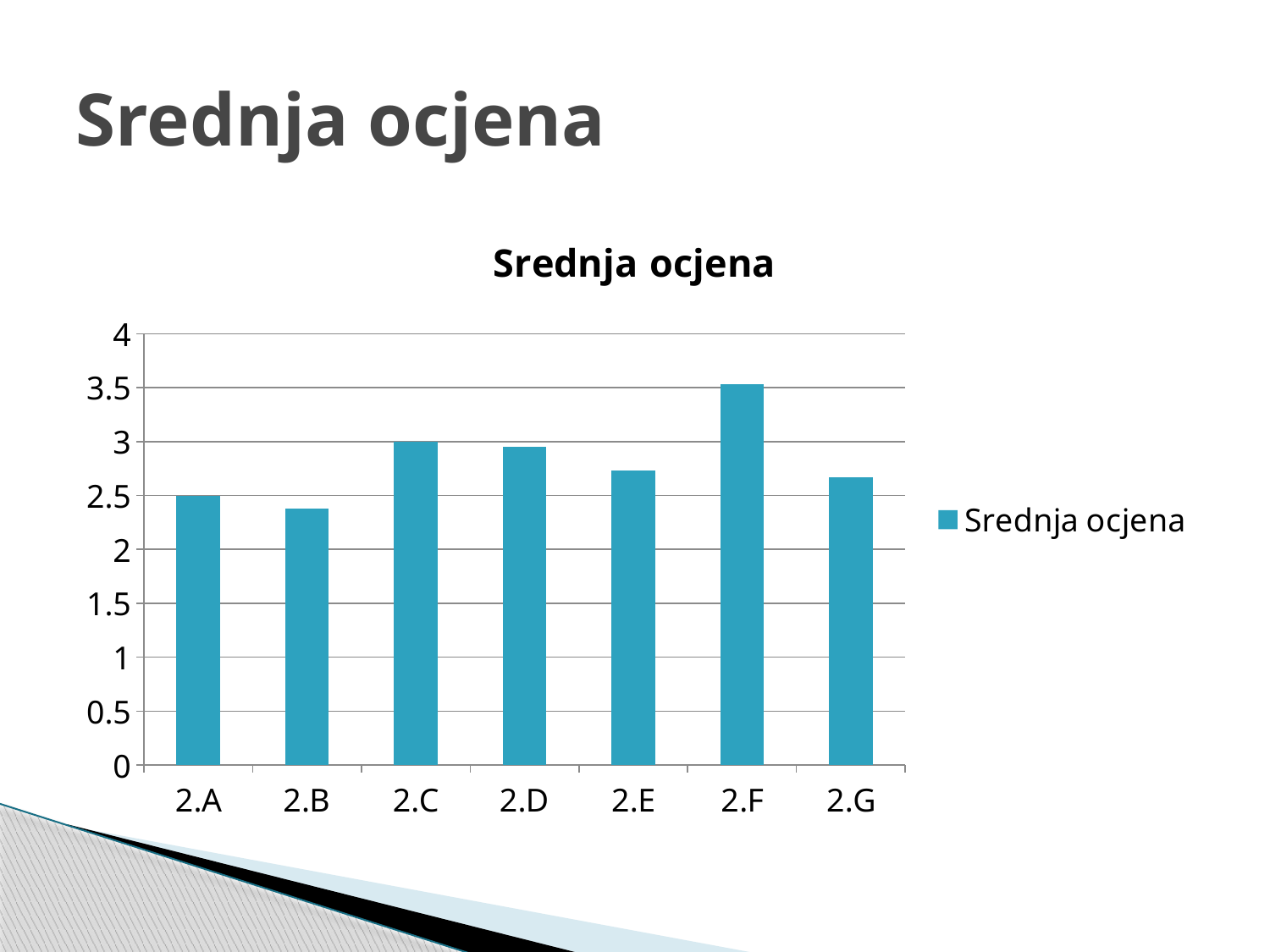
Which class has the highest Srednja ocjena? 2.F Is the value for 2.F greater or less than 3? greater What is the Srednja ocjena for 2.C? 3 How many series does the legend list? 1 Is the value for 2.G greater or less than 3? less What is the Srednja ocjena for 2.A? 2.5 What kind of chart is shown on the slide? bar chart How many categories (classes) are shown on the x axis? 7 What is the title of the chart? Srednja ocjena Which class has the lowest Srednja ocjena? 2.B Which has a higher Srednja ocjena, 2.E or 2.B? 2.E Is the value for 2.B greater or less than 2.5? less